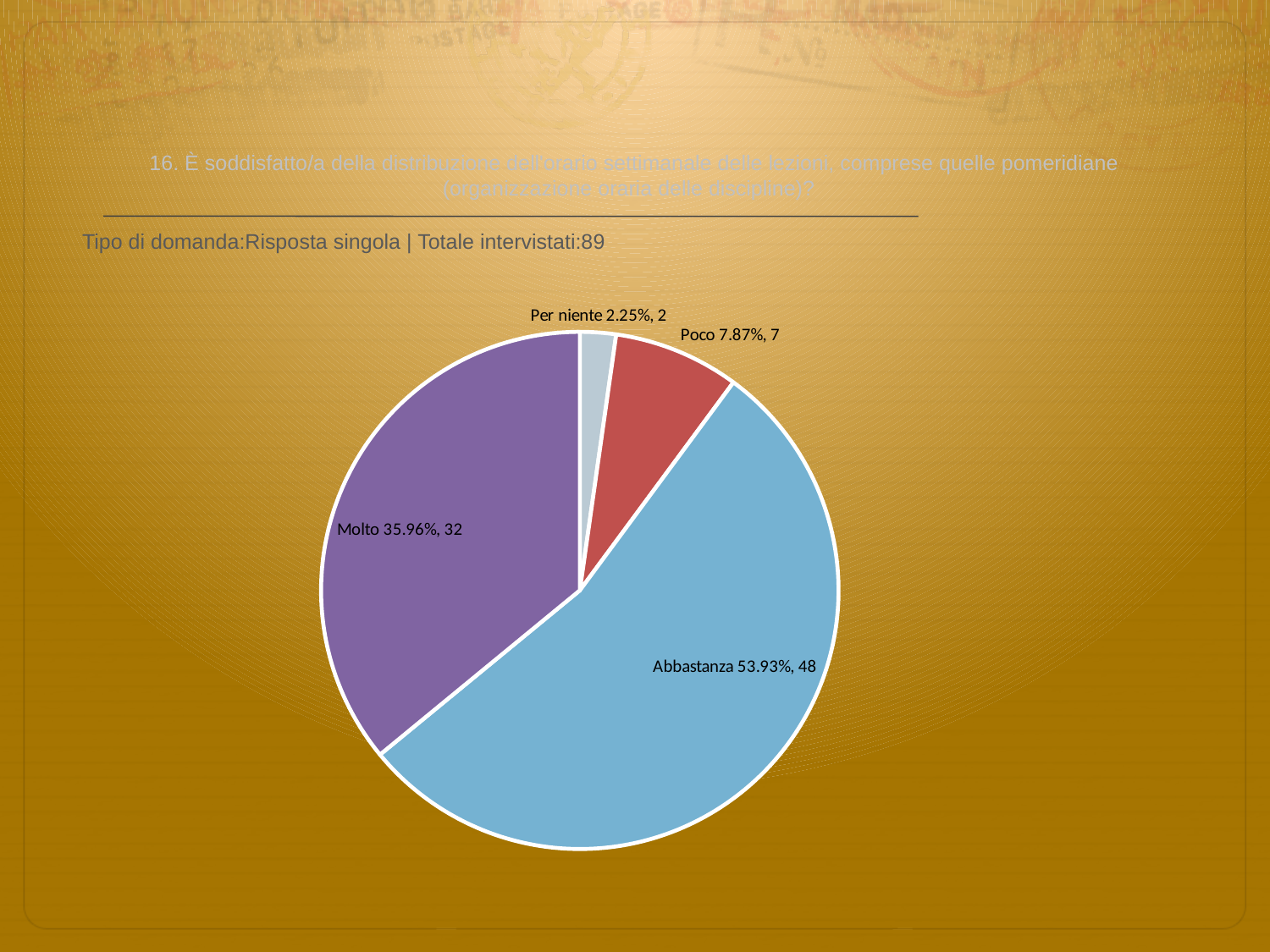
How many respondents answered Per niente? 2 How many slices does the pie chart have? 4 What percentage share does the Abbastanza slice have? 53.93% Which category has the largest slice? Abbastanza What kind of chart is shown on the slide? pie chart Which has more respondents, Poco or Per niente? Poco What colour is the Molto slice? purple How many respondents answered Molto? 32 What is the difference in respondent count between Abbastanza and Molto? 16 Which category has the smallest slice? Per niente What percentage share does the Poco slice have? 7.87% What is the total number of respondents across all slices? 89